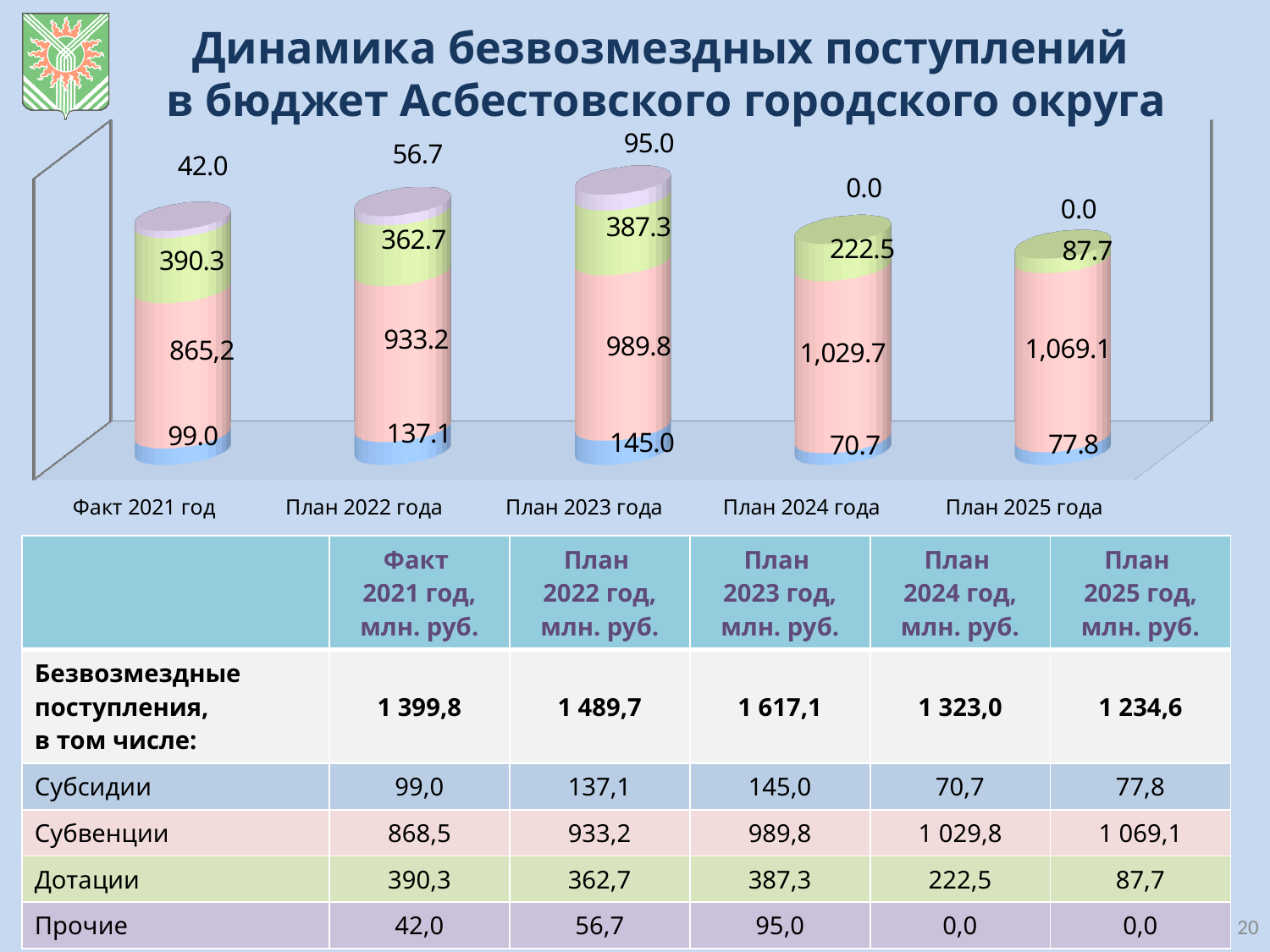
Which category has the lowest value for the bottom (blue) segment? План 2024 года Do the values of the pink segment rise or fall from Факт 2021 год to План 2025 года? Rise Which category has the highest value for the bottom (blue) segment? План 2023 года What is the value of the bottom (blue) segment of the bar for Факт 2021 год? 99.0 How many categories are shown on the x axis of the chart? 5 What is the value of the top (lilac) segment of the bar for План 2023 года? 95.0 Which has the larger pink segment value: План 2022 года or План 2023 года? План 2023 года What is the total of the stacked bar for План 2023 года? 1,617.1 What is the difference between the green segment values for План 2023 года and План 2025 года? 299.6 What is the value of the largest (pink) segment of the bar for План 2025 года? 1,069.1 What kind of chart is shown on the slide? Stacked bar chart What is the difference between the top (lilac) segment values for План 2023 года and План 2022 года? 38.3